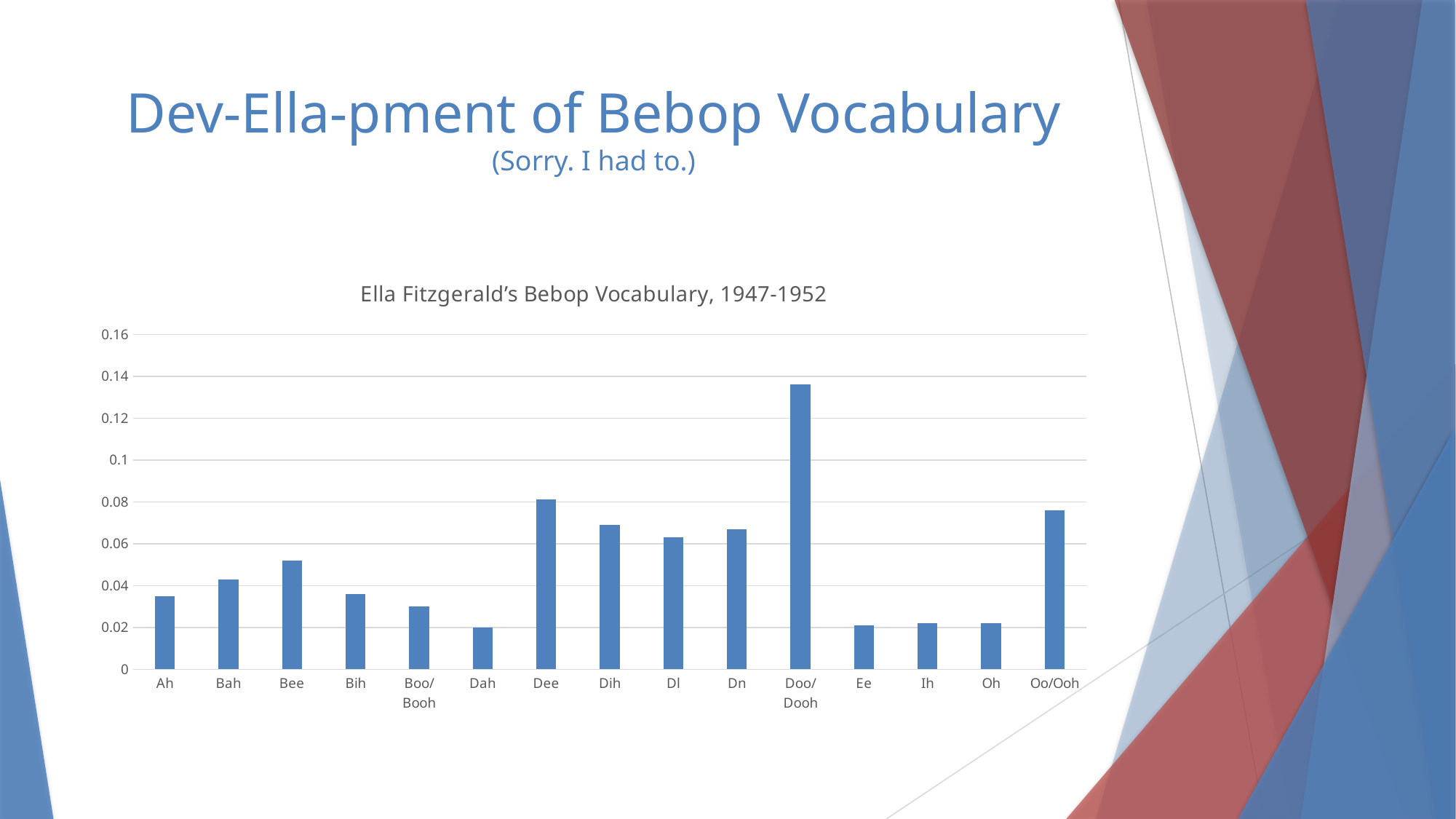
How many categories are plotted on the x axis of the chart? 15 Which has the larger value, Bah or Bee? Bee Is the value for Oo/Ooh greater or less than 0.06? greater Is the value for Dih greater or less than 0.08? less Is the value for Bee greater or less than 0.04? greater What is the title of the chart? Ella Fitzgerald's Bebop Vocabulary, 1947-1952 What is the value for Dah? 0.02 Which has the larger value, Dee or Dih? Dee What kind of chart is shown on the slide? bar chart Which category has the highest value in the chart? Doo/Dooh